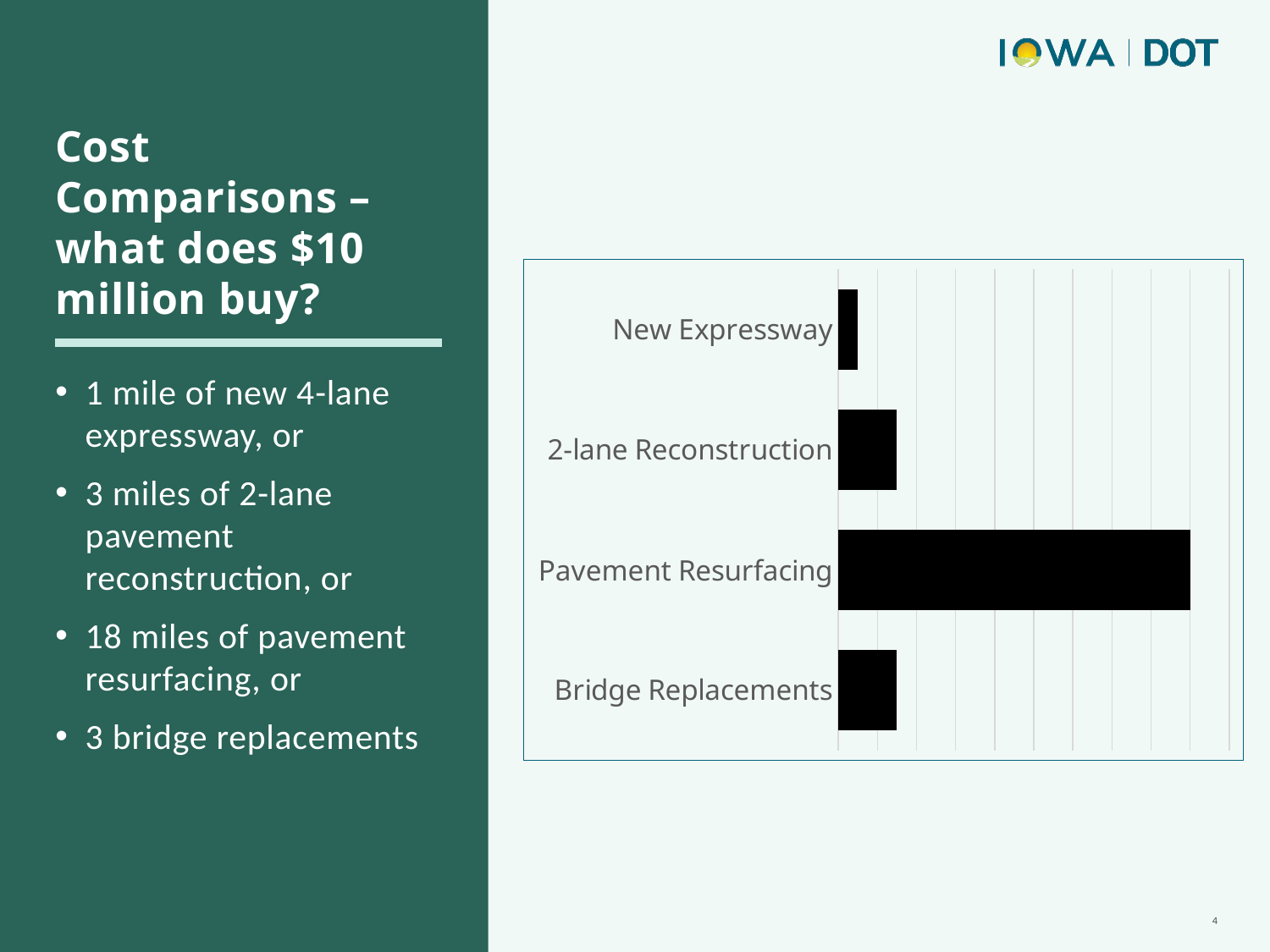
Which category has the shortest bar in the chart? New Expressway Are the bars in the chart oriented horizontally or vertically? Horizontally What is the category label of the topmost bar in the chart? New Expressway Which bar is longer: New Expressway or 2-lane Reconstruction? 2-lane Reconstruction What kind of chart is shown on the slide? Bar chart Which bar is longer: Pavement Resurfacing or Bridge Replacements? Pavement Resurfacing Which bar is longer: New Expressway or Bridge Replacements? Bridge Replacements Which category has the longest bar in the chart? Pavement Resurfacing How many categories are plotted in the bar chart? 4